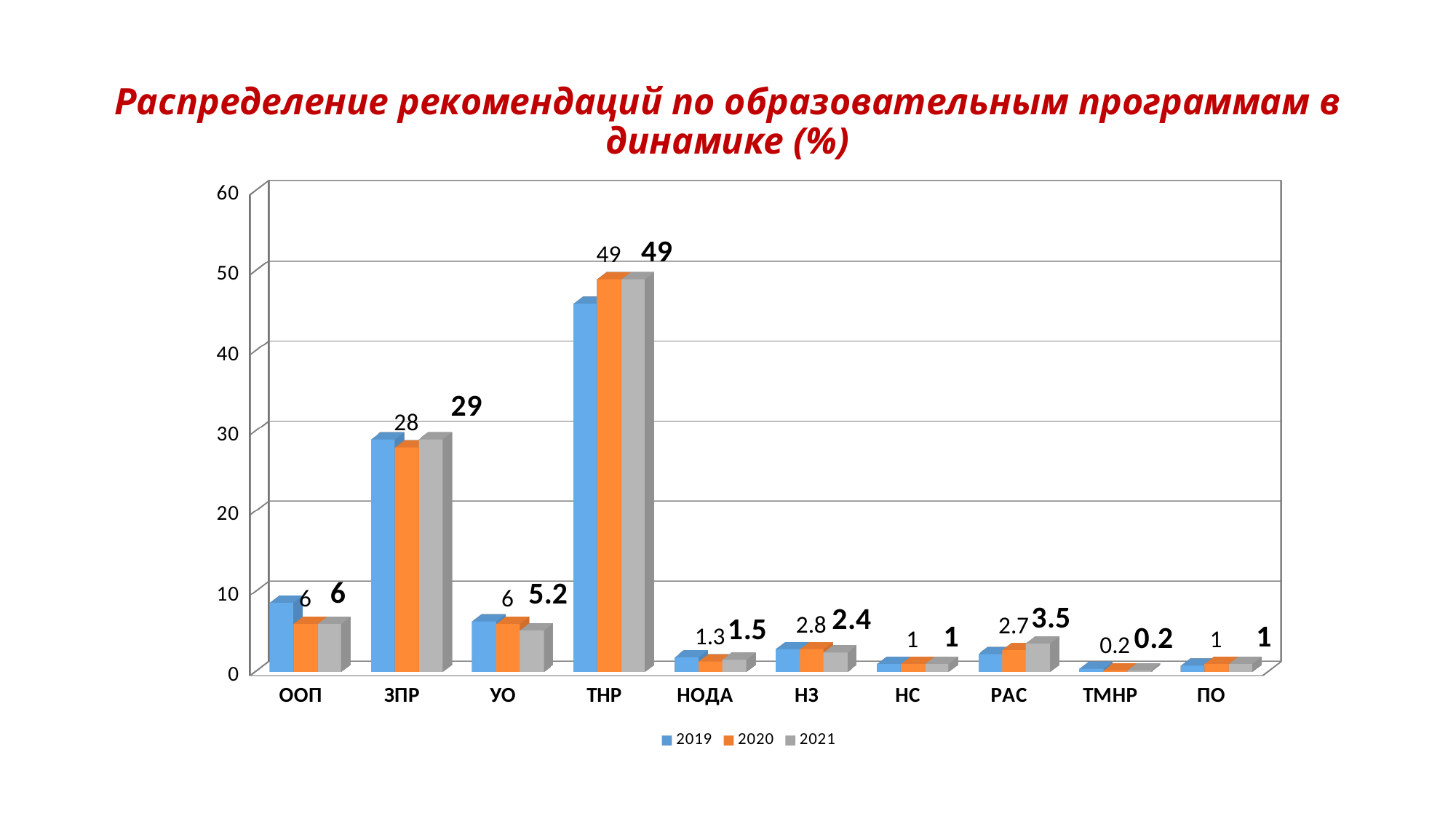
Which category has the highest value in 2021? ТНР Which category has the lowest value in 2021? ТМНР How many categories are shown on the x axis? 10 How many series does the legend list? 3 Is the value for ТНР in 2019 greater or less than 40? greater What is the value for УО in 2021? 5.2 What is the value for ТНР in 2020? 49 What kind of chart is shown on the slide? bar chart For РАС, which year has the larger value, 2020 or 2021? 2021 What is the value for ЗПР in 2021? 29 What is the difference between the 2021 and 2020 values for ЗПР? 1 What is the value for РАС in 2021? 3.5